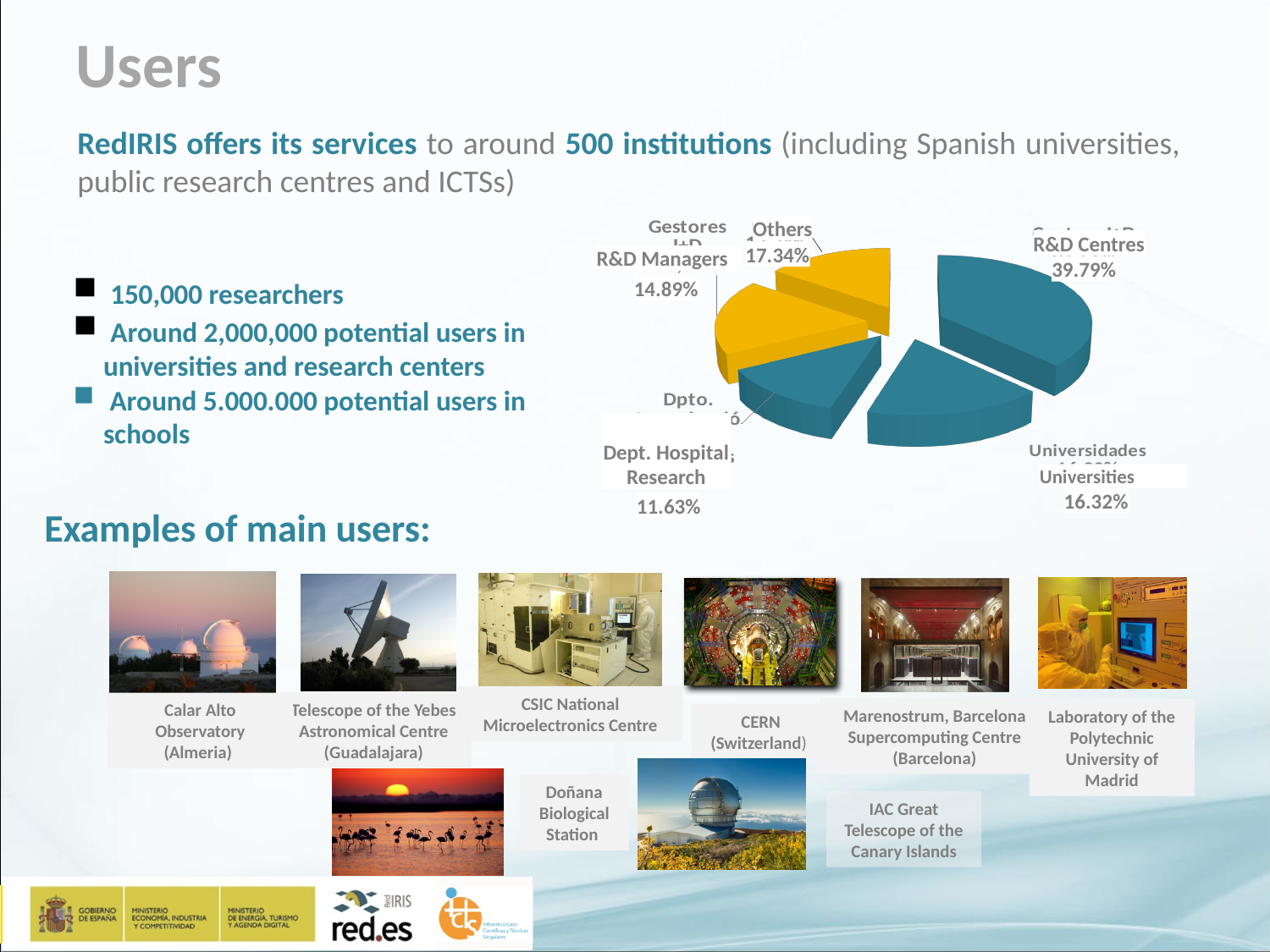
Which is larger in the pie chart, Others or Universities? Others How many slices does the pie chart have? 5 What share of the pie chart is Universities? 16.32% What share of the pie chart is Dept. Hospital Research? 11.63% Which category has the smallest share of the pie chart? Dept. Hospital Research What is the difference in percentage points between Others and R&D Managers in the pie chart? 2.45 What kind of chart is shown on the slide? pie chart What share of the pie chart is Others? 17.34% What share of the pie chart is R&D Centres? 39.79% What share of the pie chart is R&D Managers? 14.89% What is the difference in percentage points between R&D Centres and Universities in the pie chart? 23.47 Which category has the largest share of the pie chart? R&D Centres